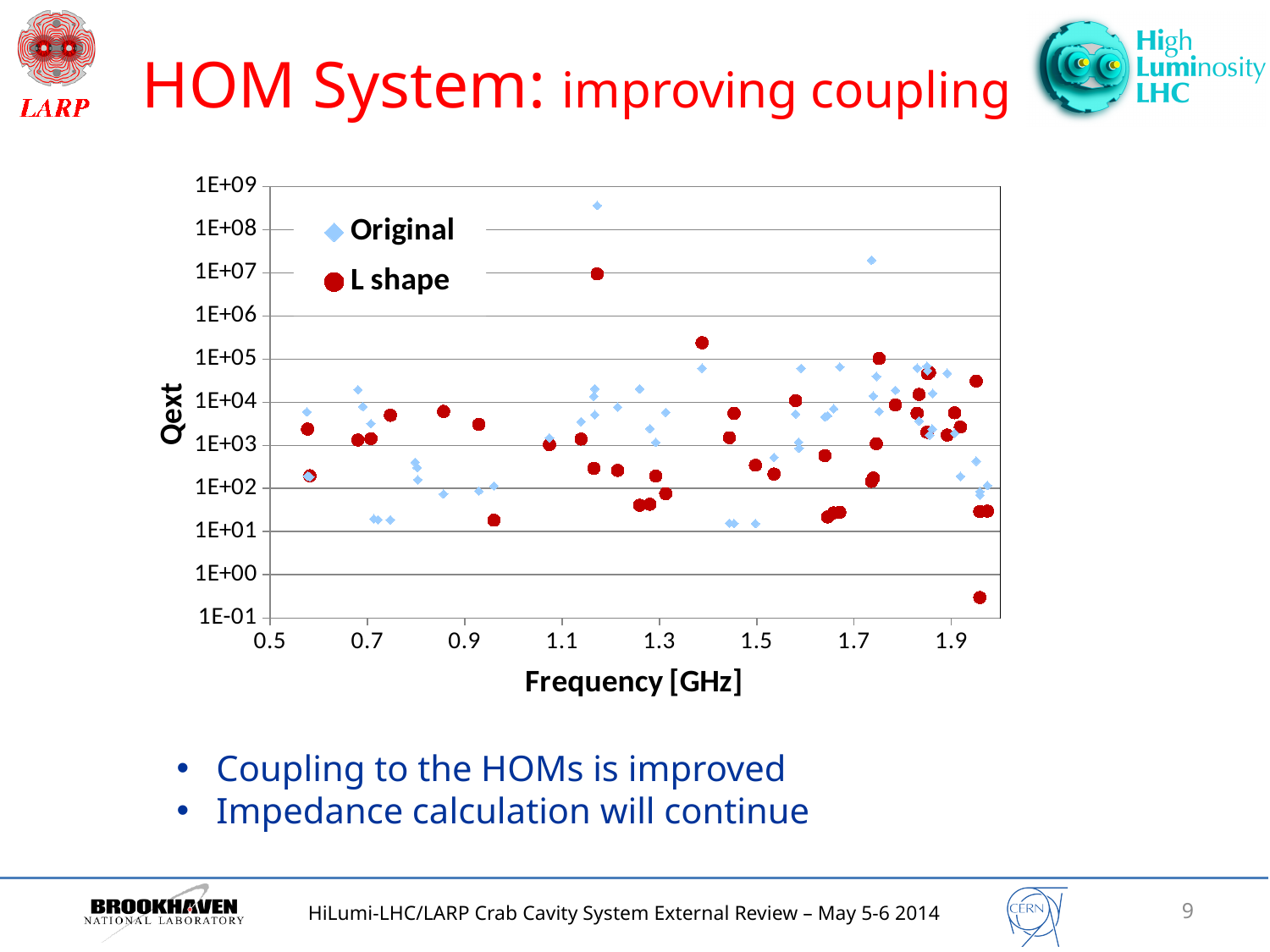
What kind of chart is shown on the slide? Scatter chart What are the two series named in the chart legend? Original and L shape Is the highest Original point on the chart greater or less than 1E+08? greater Which series contains the single lowest Qext point on the chart? L shape How many series does the chart legend list? 2 Is the lowest L shape point on the chart greater or less than 1E+00? less Is the highest L shape point on the chart greater or less than 1E+06? greater What is the title of the chart's y axis? Qext How many tick labels are shown on the x axis of the chart? 8 Which series contains the single highest Qext point on the chart? Original What is the highest value labelled on the y axis of the chart? 1E+09 What is the title of the chart's x axis? Frequency [GHz]